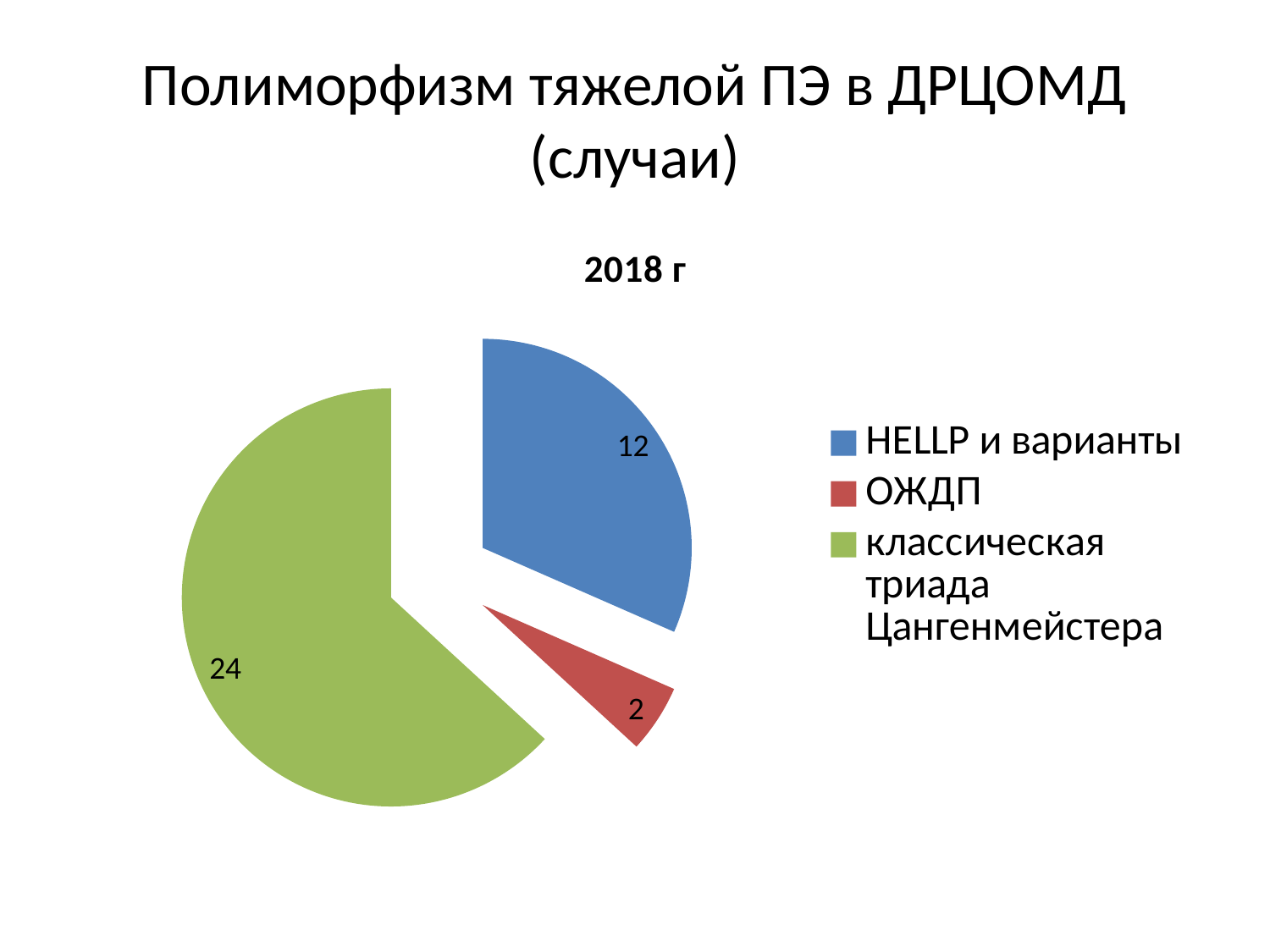
What is the value for классическая триада Цангенмейстера? 24 What type of chart is shown on the slide? pie chart How many slices does the pie chart have? 3 Which category has the largest slice? классическая триада Цангенмейстера What is the difference between the values for классическая триада Цангенмейстера and HELLP и варианты? 12 Which is larger, the value for HELLP и варианты or the value for ОЖДП? HELLP и варианты What is the chart's title? 2018 г What is the value for HELLP и варианты? 12 What is the total of all slices in the pie chart? 38 What is the value for ОЖДП? 2 How many entries does the legend list? 3 Which category has the smallest slice? ОЖДП